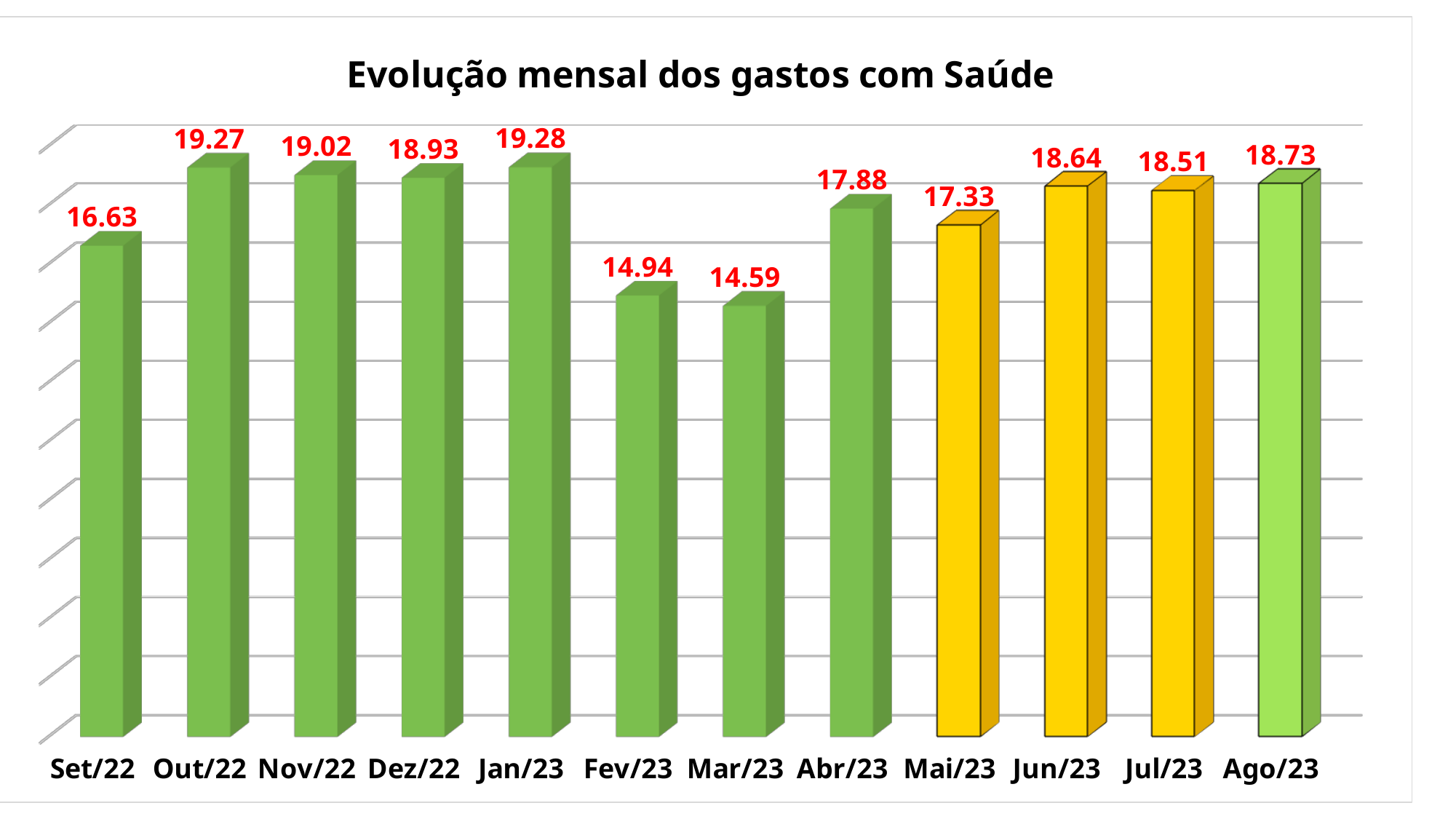
What is the value for Ago/23? 18.73 What is the value for Fev/23? 14.94 What is the value for Set/22? 16.63 Do the values rise or fall from Jan/23 to Mar/23? Fall What is the title of the chart? Evolução mensal dos gastos com Saúde Which month has the highest value? Jan/23 What is the difference between the values for Jan/23 and Mar/23? 4.69 Which month has the lowest value? Mar/23 How many months are shown on the chart? 12 Which is larger, the value for Abr/23 or the value for Mai/23? Abr/23 What kind of chart is this? Bar chart What is the difference between the values for Out/22 and Set/22? 2.64